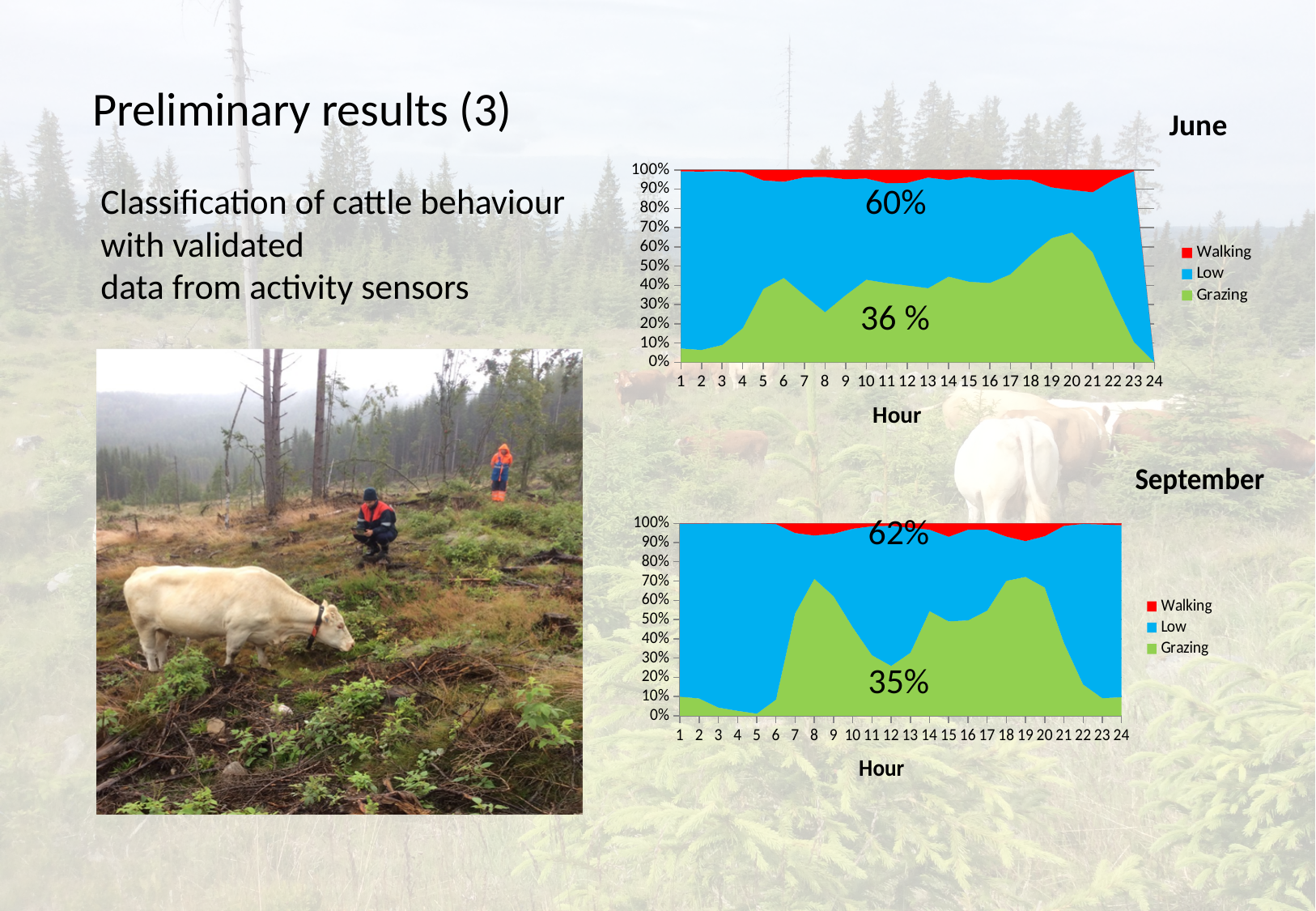
How many hours are plotted along the x axis of the June chart? 24 What is the x-axis title of the September chart? Hour In the September chart, is the Grazing share at hour 3 greater or less than 10%? less What are the legend entries of the June chart? Walking, Low, Grazing In the September chart, what overall share is printed on the Low (blue) area? 62% In the June chart, is the Grazing share at hour 20 greater or less than 60%? greater In the September chart, what overall share is printed on the Grazing (green) area? 35% In the June chart, what overall share is printed on the Low (blue) area? 60% In the June chart, which hour has the larger Grazing share, hour 8 or hour 20? hour 20 What kind of chart is the June chart? area chart How many series does the legend of the September chart list? 3 In the June chart, what overall share is printed on the Grazing (green) area? 36 %